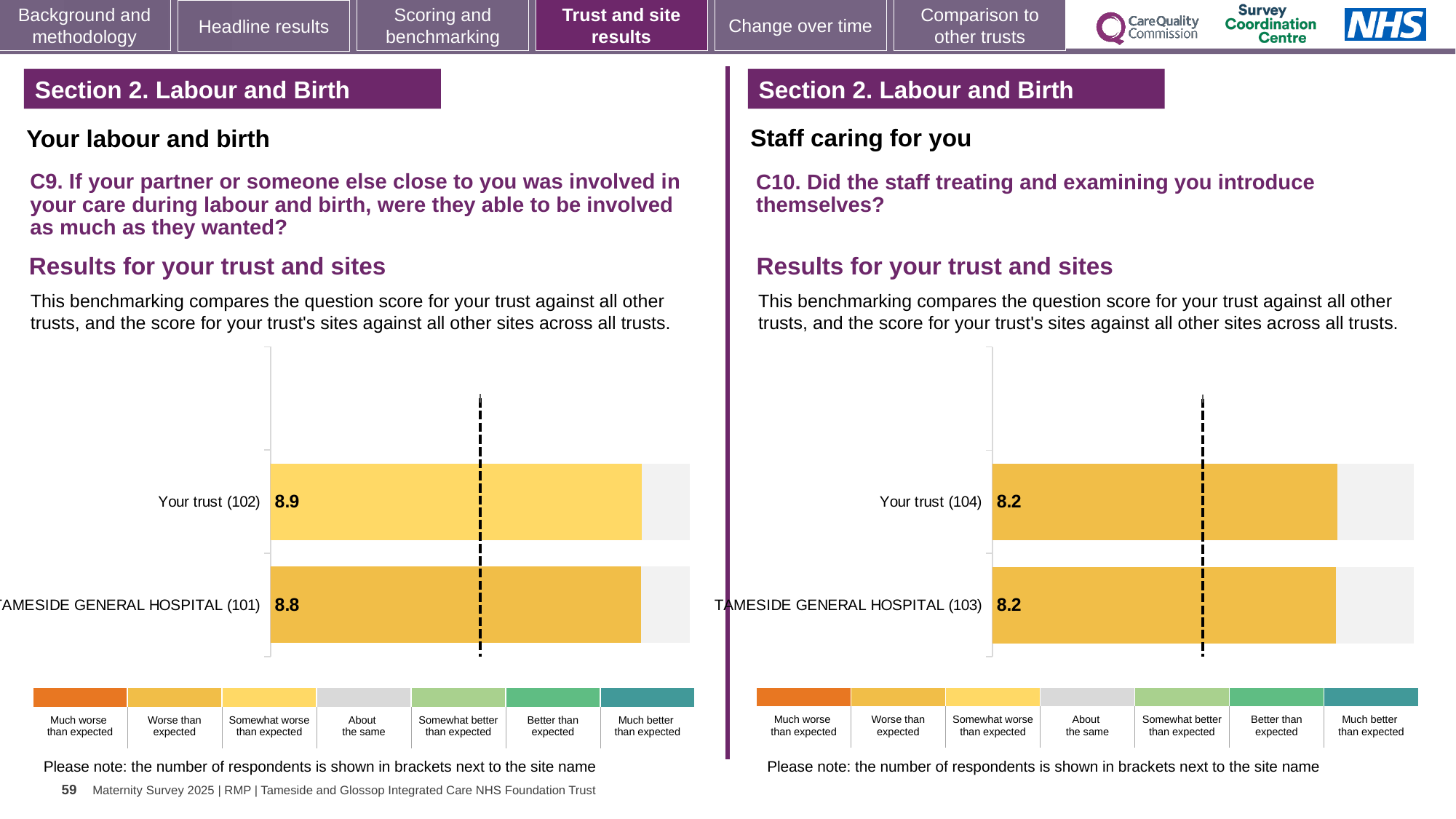
On the right chart (C10), how many respondents are shown in brackets for TAMESIDE GENERAL HOSPITAL? 103 On the left chart (C9), which has the higher score, Your trust or TAMESIDE GENERAL HOSPITAL? Your trust On the right chart (C10), what is the score for TAMESIDE GENERAL HOSPITAL? 8.2 On the left chart (C9), what is the score for TAMESIDE GENERAL HOSPITAL? 8.8 On the left chart (C9), what is the difference between the score for Your trust and the score for TAMESIDE GENERAL HOSPITAL? 0.1 On the right chart (C10), what is the score for Your trust? 8.2 On the left chart (C9), how many respondents are shown in brackets for Your trust? 102 On the left chart (C9), what is the score for Your trust? 8.9 On the right chart (C10), what is the difference between the score for Your trust and the score for TAMESIDE GENERAL HOSPITAL? 0 How many bars are plotted on the right chart (C10)? 2 How many bars are plotted on the left chart (C9)? 2 What kind of chart is used on the left (C9)? Bar chart